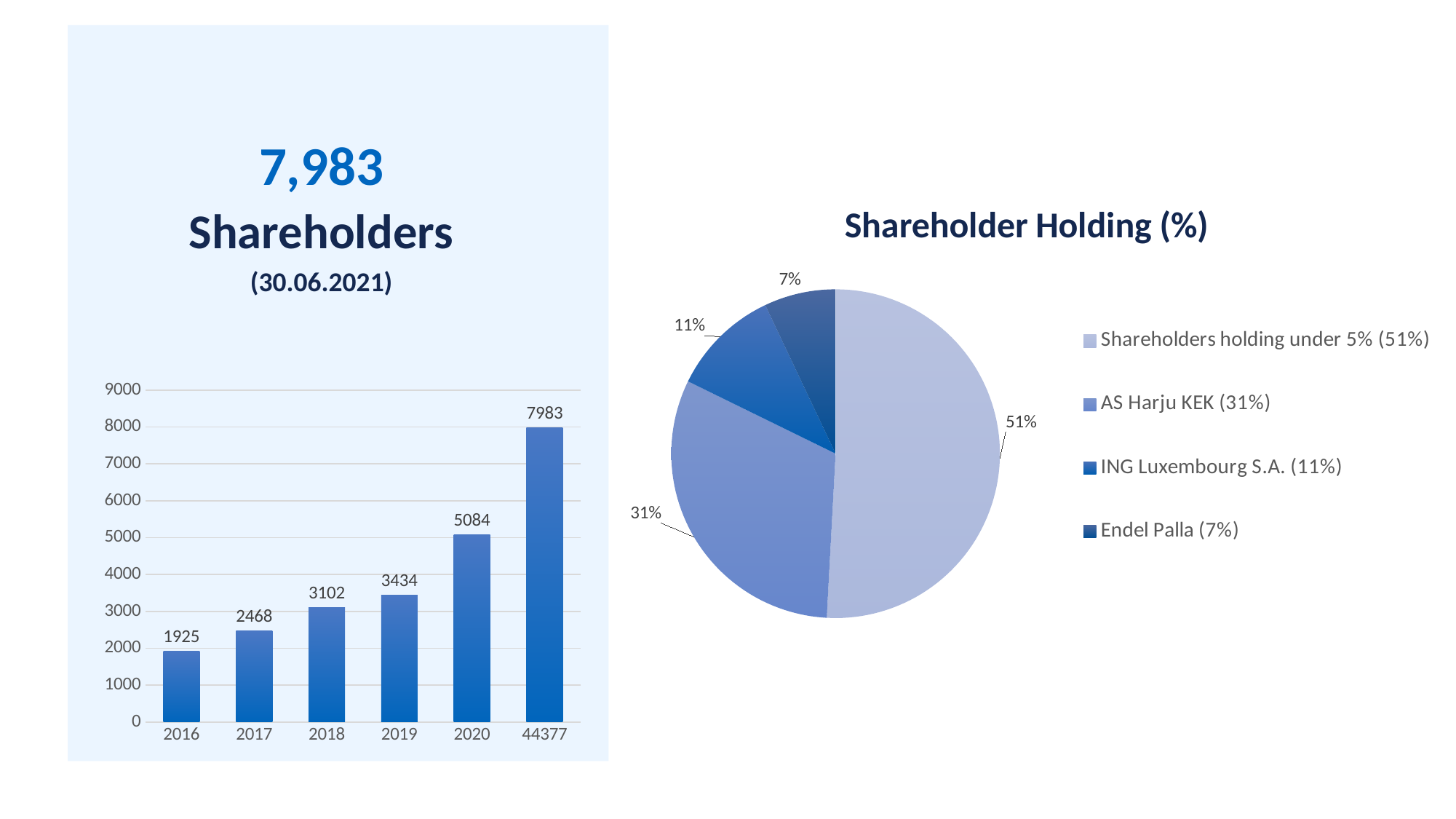
In the bar chart on the left, what is the value for 2016? 1925 In the bar chart on the left, which category has the highest value? 44377 In the Shareholder Holding (%) pie chart, what share does AS Harju KEK hold? 31% How many bars are in the bar chart on the left? 6 In the bar chart on the left, what is the value for 2019? 3434 In the bar chart on the left, what is the difference between the values for 2020 and 2019? 1650 What kind of chart is the chart on the left? bar chart In the bar chart on the left, which is larger, the value for 2017 or the value for 2018? 2018 In the bar chart on the left, which category has the lowest value? 2016 In the Shareholder Holding (%) pie chart, which slice is the smallest? Endel Palla Do the values in the bar chart on the left rise or fall from left to right? rise How many entries does the legend of the Shareholder Holding (%) pie chart list? 4